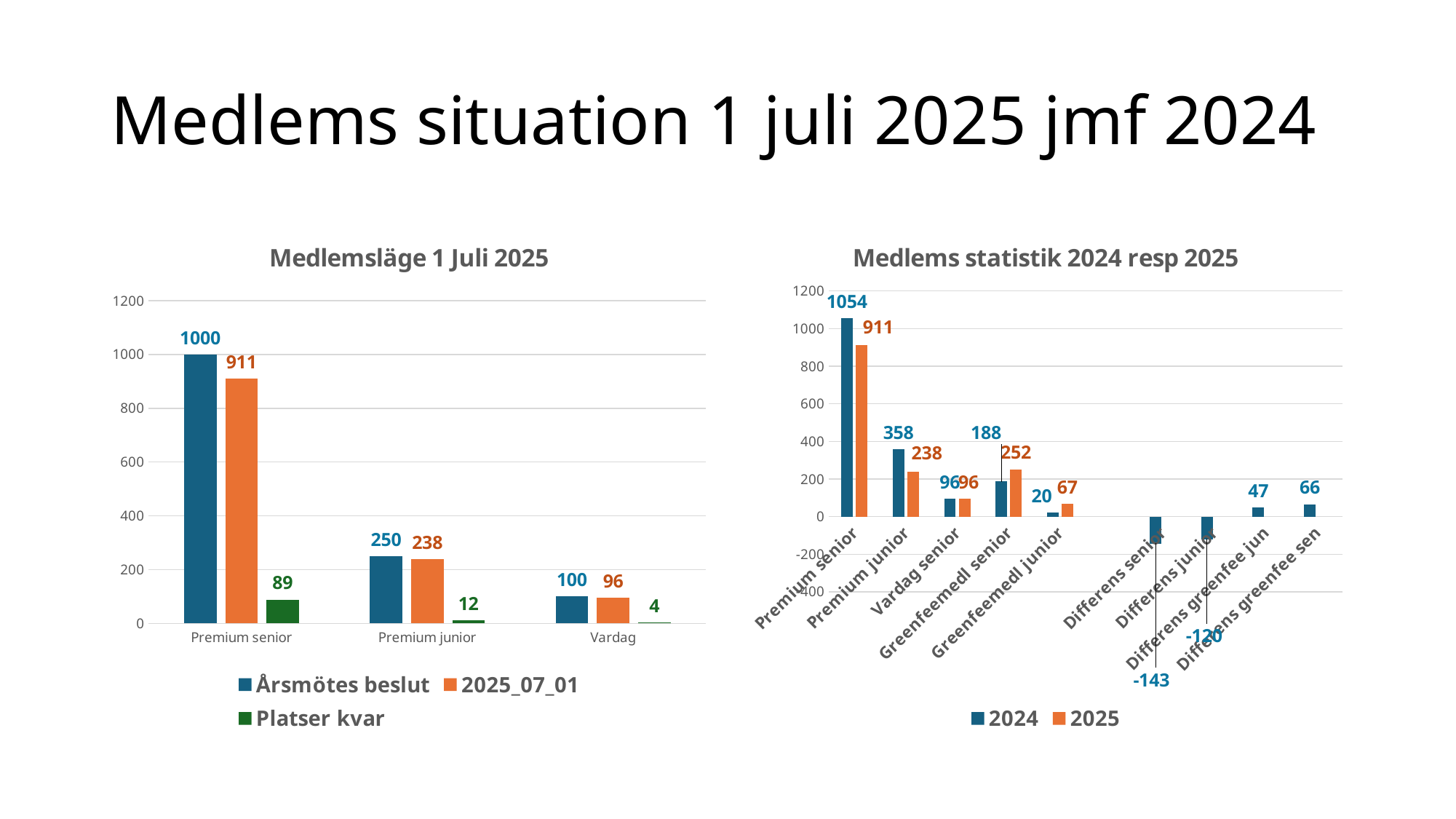
In the chart titled 'Medlems statistik 2024 resp 2025', what is the 2025 value for Greenfeemedl senior? 252 In the chart titled 'Medlems statistik 2024 resp 2025', what is the value shown for Differens greenfee sen? 66 In the chart titled 'Medlems statistik 2024 resp 2025', which is larger for Greenfeemedl junior, the 2024 value or the 2025 value? 2025 In the chart titled 'Medlemsläge 1 Juli 2025', how many series does the legend list? 3 In the chart titled 'Medlems statistik 2024 resp 2025', what is the difference between the 2024 and 2025 values for Premium senior? 143 In the chart titled 'Medlemsläge 1 Juli 2025', which category has the lowest Platser kvar value? Vardag In the chart titled 'Medlemsläge 1 Juli 2025', how many categories are shown on the x axis? 3 In the chart titled 'Medlemsläge 1 Juli 2025', what is the value of Årsmötes beslut for Premium senior? 1000 In the chart titled 'Medlemsläge 1 Juli 2025', what is the value of Platser kvar for Premium junior? 12 In the chart titled 'Medlems statistik 2024 resp 2025', what is the 2024 value for Premium junior? 358 In the chart titled 'Medlemsläge 1 Juli 2025', what is the difference between Årsmötes beslut and 2025_07_01 for Premium senior? 89 What type of chart is 'Medlems statistik 2024 resp 2025'? Bar chart